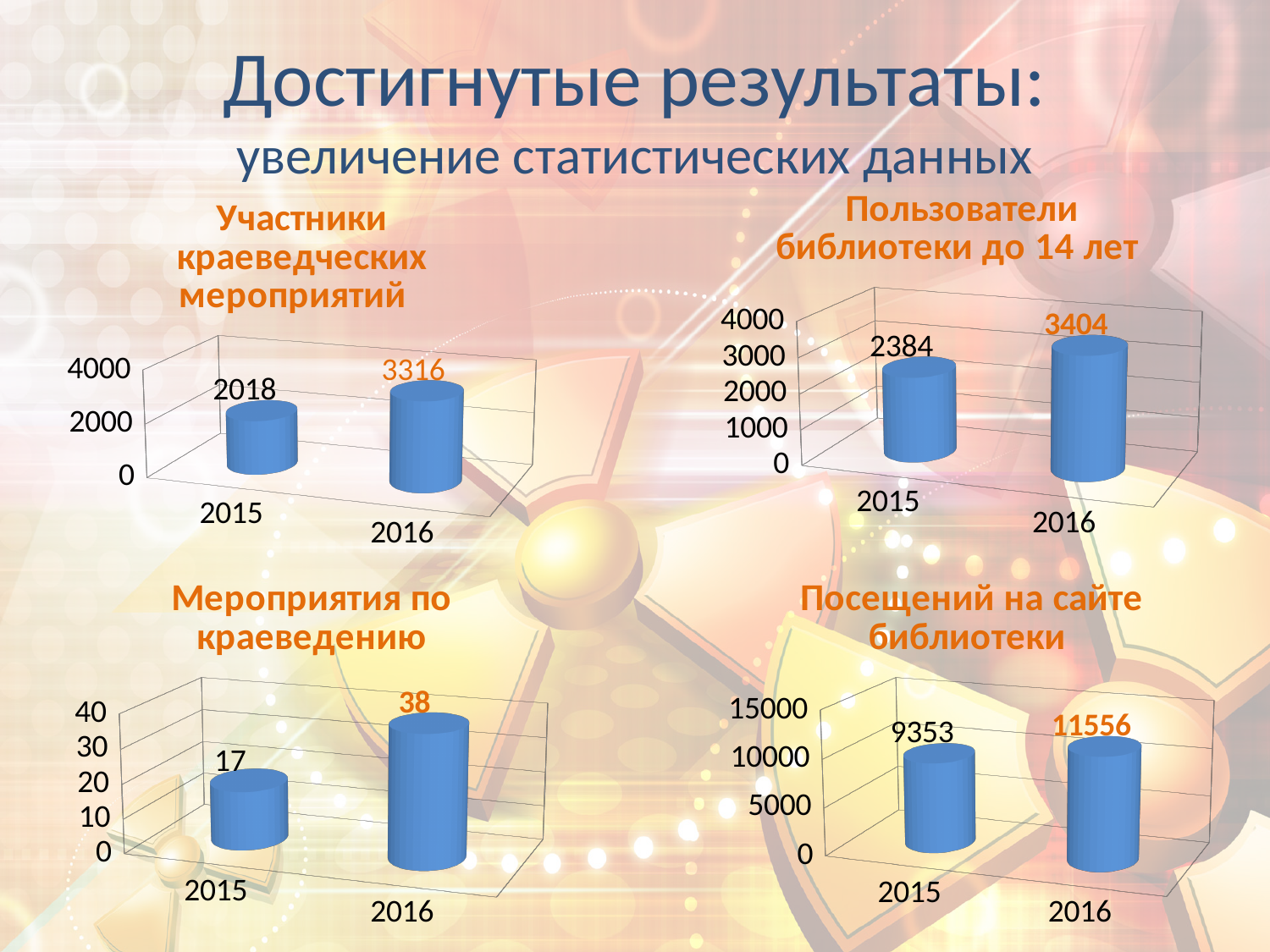
In the chart titled "Пользователи библиотеки до 14 лет", what is the difference between the 2016 and 2015 values? 1020 In the chart titled "Участники краеведческих мероприятий", what is the value for 2016? 3316 In the chart titled "Посещений на сайте библиотеки", which year has the highest value? 2016 In the chart titled "Мероприятия по краеведению", what is the difference between the 2016 and 2015 values? 21 In the chart titled "Участники краеведческих мероприятий", what is the difference between the 2016 and 2015 values? 1298 What kind of chart is the one titled "Посещений на сайте библиотеки"? bar chart In the chart titled "Посещений на сайте библиотеки", what is the value for 2015? 9353 In the chart titled "Участники краеведческих мероприятий", what is the value for 2015? 2018 How many categories are shown in the chart titled "Пользователи библиотеки до 14 лет"? 2 In the chart titled "Мероприятия по краеведению", what is the value for 2016? 38 In the chart titled "Пользователи библиотеки до 14 лет", what is the value for 2015? 2384 In the chart titled "Мероприятия по краеведению", do the values rise or fall from 2015 to 2016? rise